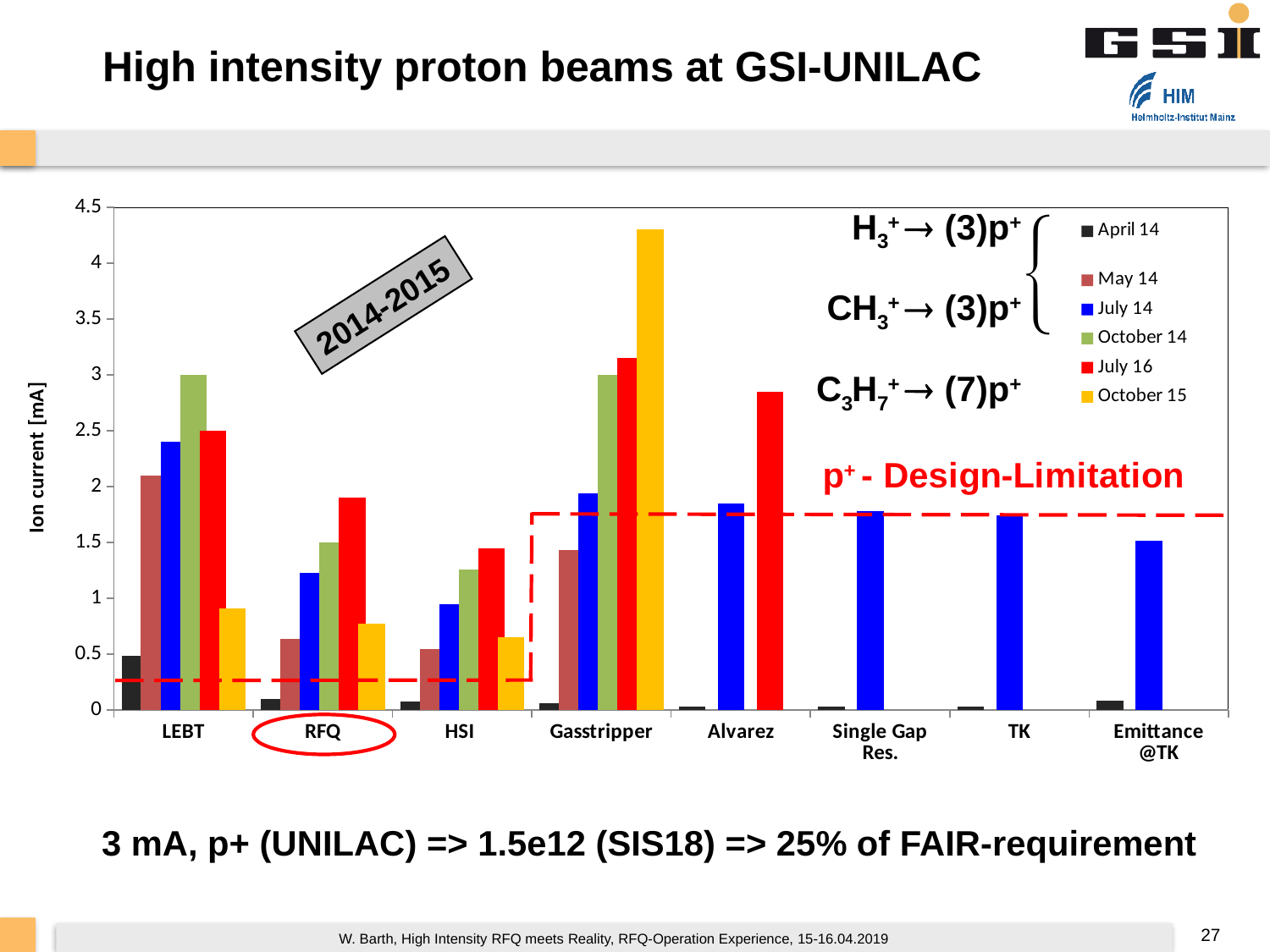
Is the July 14 value for RFQ greater or less than 1.5? less Which series has the lowest value for LEBT? April 14 How many series does the chart legend list? 6 Which category and series has the tallest bar in the chart? Gasstripper, October 15 What is the title of the y axis of the chart? Ion current [mA] How many categories are shown along the x axis of the chart? 8 What kind of chart is shown on the slide? bar chart What label is given to the red dashed line in the chart? p+ - Design-Limitation Which category has the highest July 14 value? LEBT For Alvarez, which is larger: the July 14 value or the July 16 value? July 16 Is the October 15 value for Gasstripper greater or less than 4? greater Which category has the highest July 16 value? Gasstripper